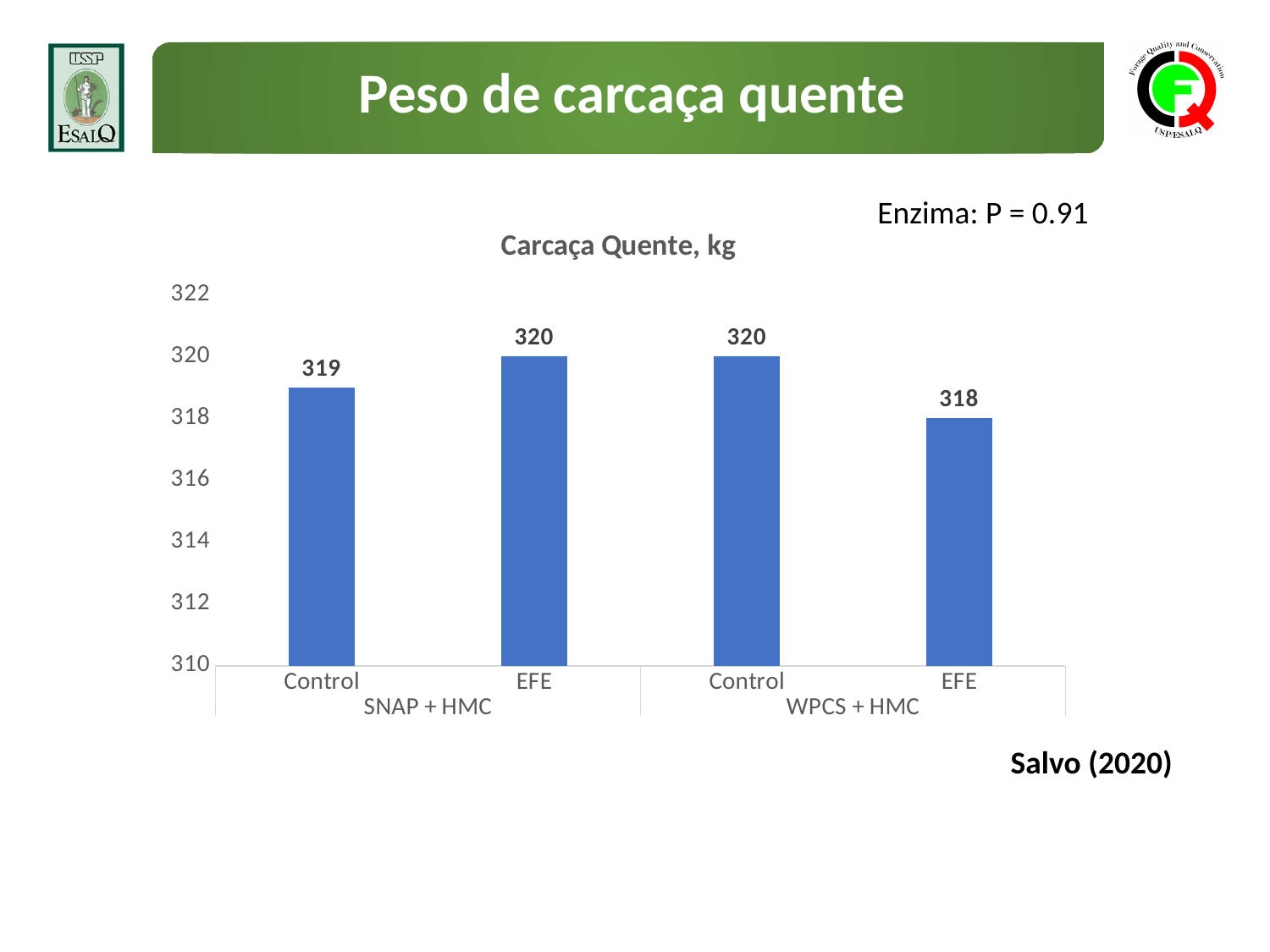
What is the value for EFE under WPCS + HMC? 318 What is the value for Control under SNAP + HMC? 319 What is the difference between Control and EFE under WPCS + HMC? 2 Is the value for EFE under WPCS + HMC greater or less than 320? less What is the title of the chart? Carcaça Quente, kg What is the value for EFE under SNAP + HMC? 320 Which is larger: Control under SNAP + HMC or EFE under SNAP + HMC? EFE under SNAP + HMC What is the value for Control under WPCS + HMC? 320 What is the difference between EFE under SNAP + HMC and Control under SNAP + HMC? 1 Which bar has the lowest value? EFE under WPCS + HMC How many bars are plotted in the chart? 4 What kind of chart is shown on the slide? bar chart